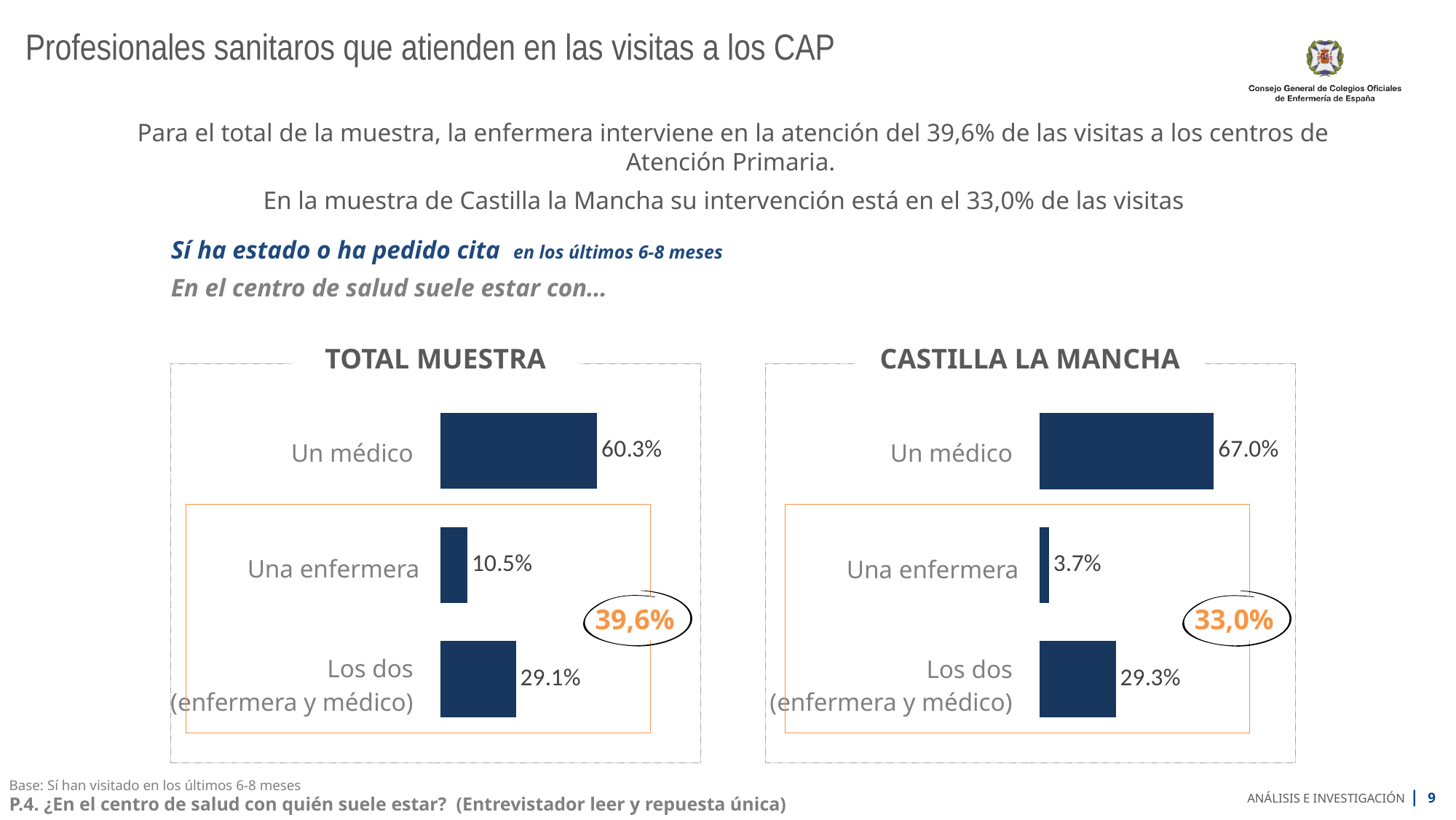
In the CASTILLA LA MANCHA chart, what is the value for Una enfermera? 3.7% In the TOTAL MUESTRA chart, what is the value for Una enfermera? 10.5% In the CASTILLA LA MANCHA chart, what is the difference between Un médico and Una enfermera? 63.3% In the TOTAL MUESTRA chart, what is the difference between Un médico and Los dos (enfermera y médico)? 31.2% Which is larger: Una enfermera in the TOTAL MUESTRA chart or Una enfermera in the CASTILLA LA MANCHA chart? TOTAL MUESTRA In the TOTAL MUESTRA chart, what is the value for Un médico? 60.3% In the CASTILLA LA MANCHA chart, what is the value for Los dos (enfermera y médico)? 29.3% What kind of chart is the CASTILLA LA MANCHA chart? Bar chart In the CASTILLA LA MANCHA chart, which category has the highest value? Un médico What value is circled in orange next to the CASTILLA LA MANCHA chart? 33,0% In the TOTAL MUESTRA chart, which category has the lowest value? Una enfermera How many categories does the TOTAL MUESTRA chart show? 3